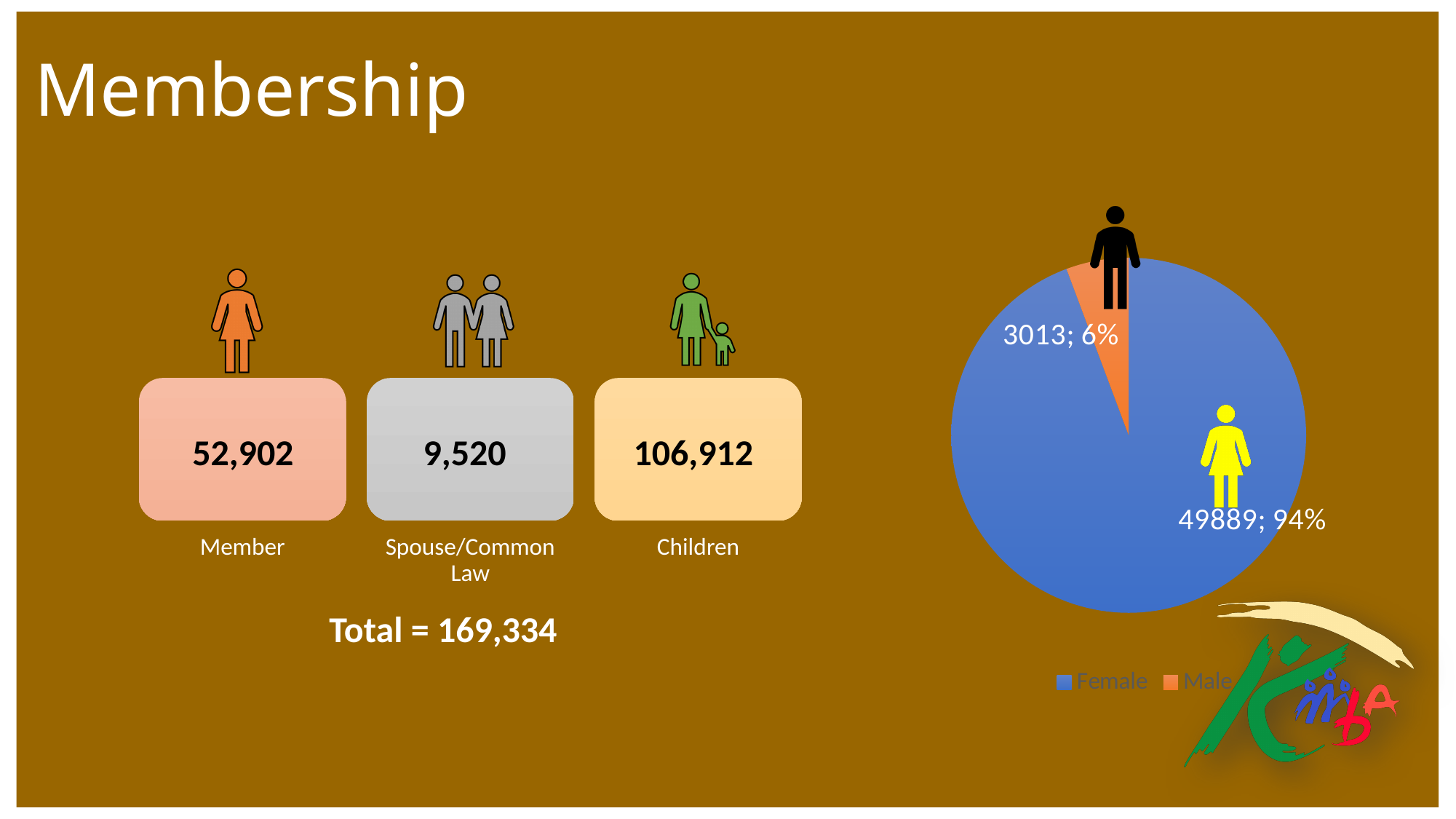
In the pie chart, which category has the largest slice? Female What entries does the pie chart's legend list? Female, Male In the pie chart, what is the value for Female? 49889 How many slices does the pie chart have? 2 In the pie chart, what share of the pie does the Male slice represent? 6% In the pie chart, which is larger, the Female value or the Male value? Female In the pie chart, which category has the smallest slice? Male In the pie chart, what is the difference between the Female value and the Male value? 46876 What kind of chart is shown on the right of the slide? pie chart In the pie chart, what is the value for Male? 3013 In the pie chart, what colour is the Female slice? blue In the pie chart, what share of the pie does the Female slice represent? 94%